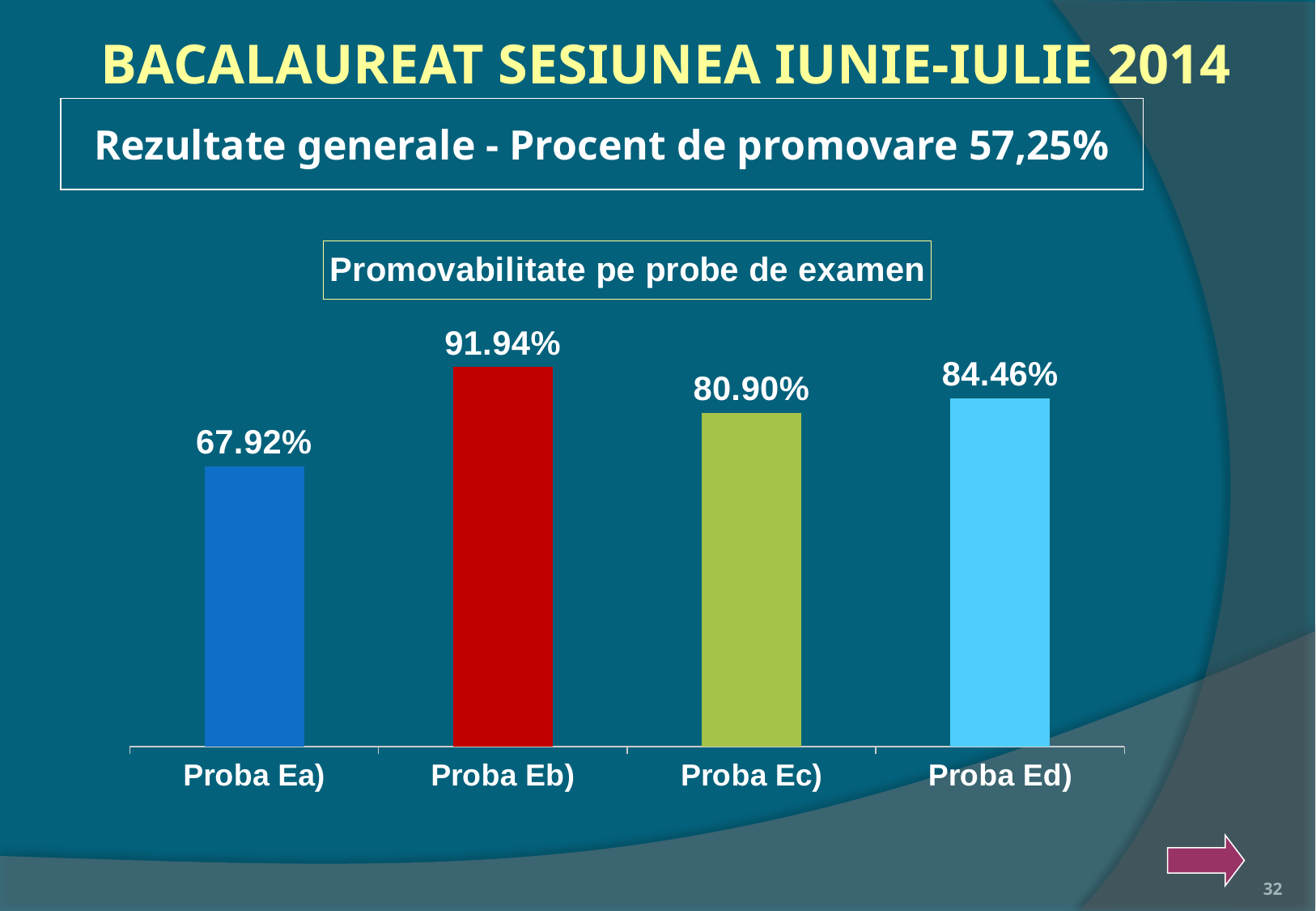
What type of chart is used to show the pass rates per exam test? Bar chart Which has a higher pass rate, Proba Ec) or Proba Ed)? Proba Ed) How many exam tests are shown in the chart? 4 What is the pass rate shown for Proba Ec)? 80.90% What is the pass rate shown for Proba Eb)? 91.94% What is the difference between the pass rates of Proba Ed) and Proba Ec)? 3.56% Which exam test has the highest pass rate? Proba Eb) What is the pass rate shown for Proba Ea)? 67.92% What is the title of the chart? Promovabilitate pe probe de examen Which exam test has the lowest pass rate? Proba Ea) What is the pass rate shown for Proba Ed)? 84.46% What is the difference between the pass rates of Proba Eb) and Proba Ea)? 24.02%